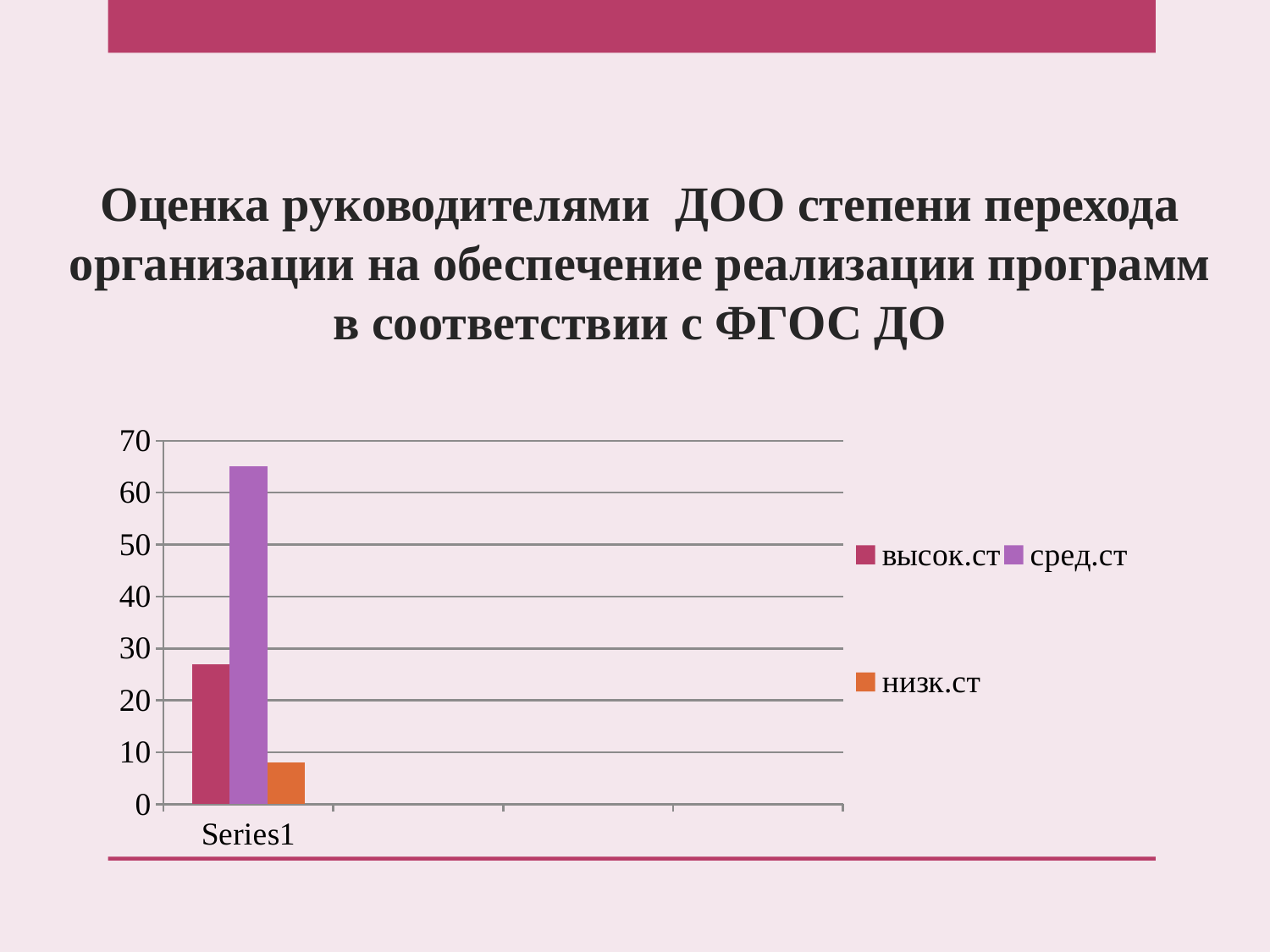
What kind of chart is shown on the slide? bar chart Which is larger, the value for сред.ст or the value for высок.ст? сред.ст Is the value for сред.ст greater or less than 60? greater Is the value for высок.ст greater or less than 30? less Is the value for высок.ст greater or less than 20? greater What is the highest value shown on the y axis? 70 What is the label shown on the x axis under the bars? Series1 Which series has the lowest bar? низк.ст Which is larger, the value for высок.ст or the value for низк.ст? высок.ст How many series does the legend list? 3 Which series has the highest bar? сред.ст